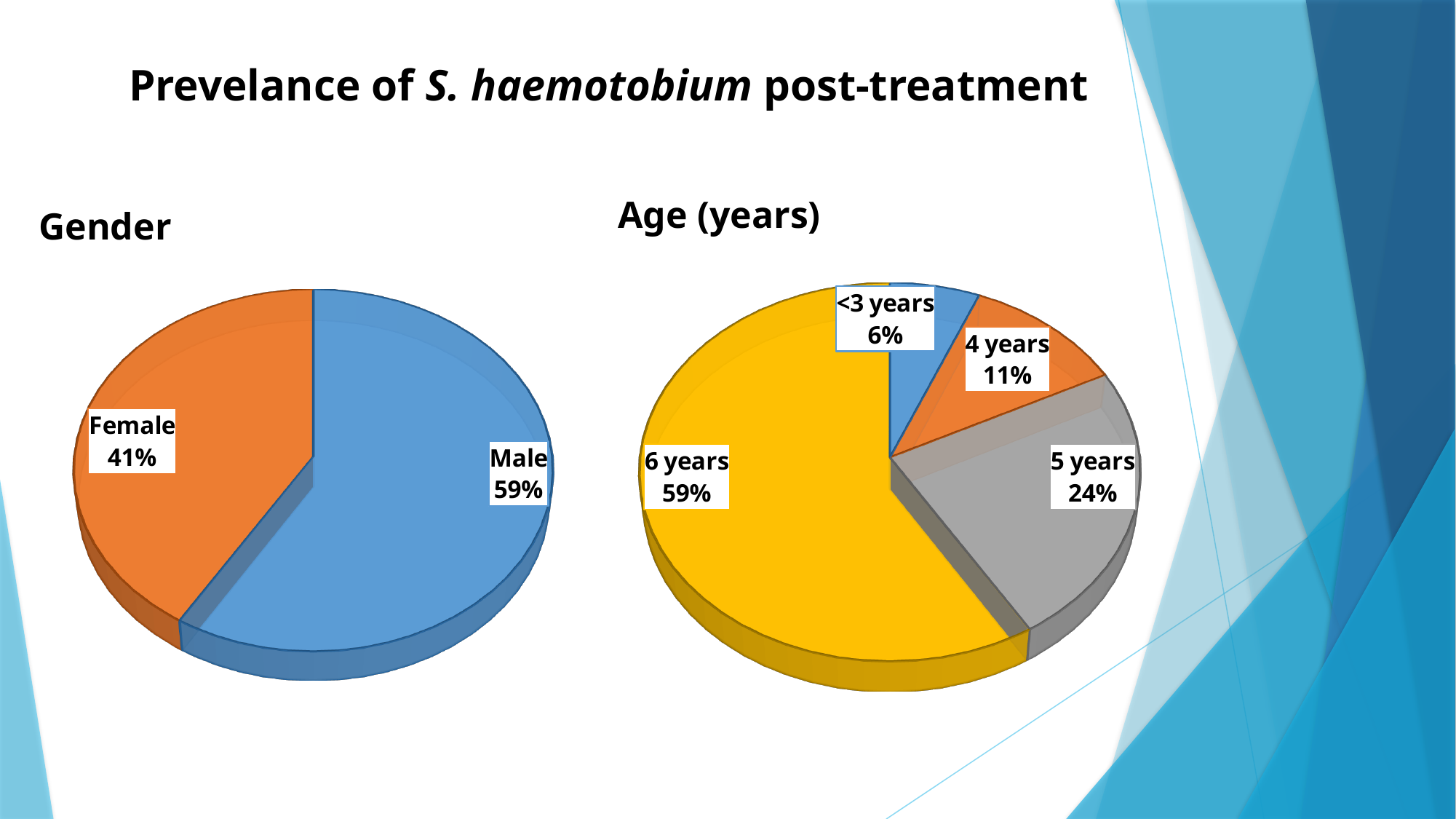
In the Age (years) pie chart, what is the difference between the shares for 5 years and 4 years? 13% What kind of chart is the Age (years) chart? Pie chart In the Age (years) pie chart, which age group has the smallest share? <3 years In the Gender pie chart, which category has the larger share, Male or Female? Male In the Age (years) pie chart, what share is labelled for <3 years? 6% In the Age (years) pie chart, how many age groups are shown? 4 In the Gender pie chart, what share is labelled for Female? 41% In the Gender pie chart, how many slices are there? 2 In the Gender pie chart, what share is labelled for Male? 59% In the Age (years) pie chart, which age group has the largest share? 6 years In the Gender pie chart, what is the difference between the Male and Female shares? 18%